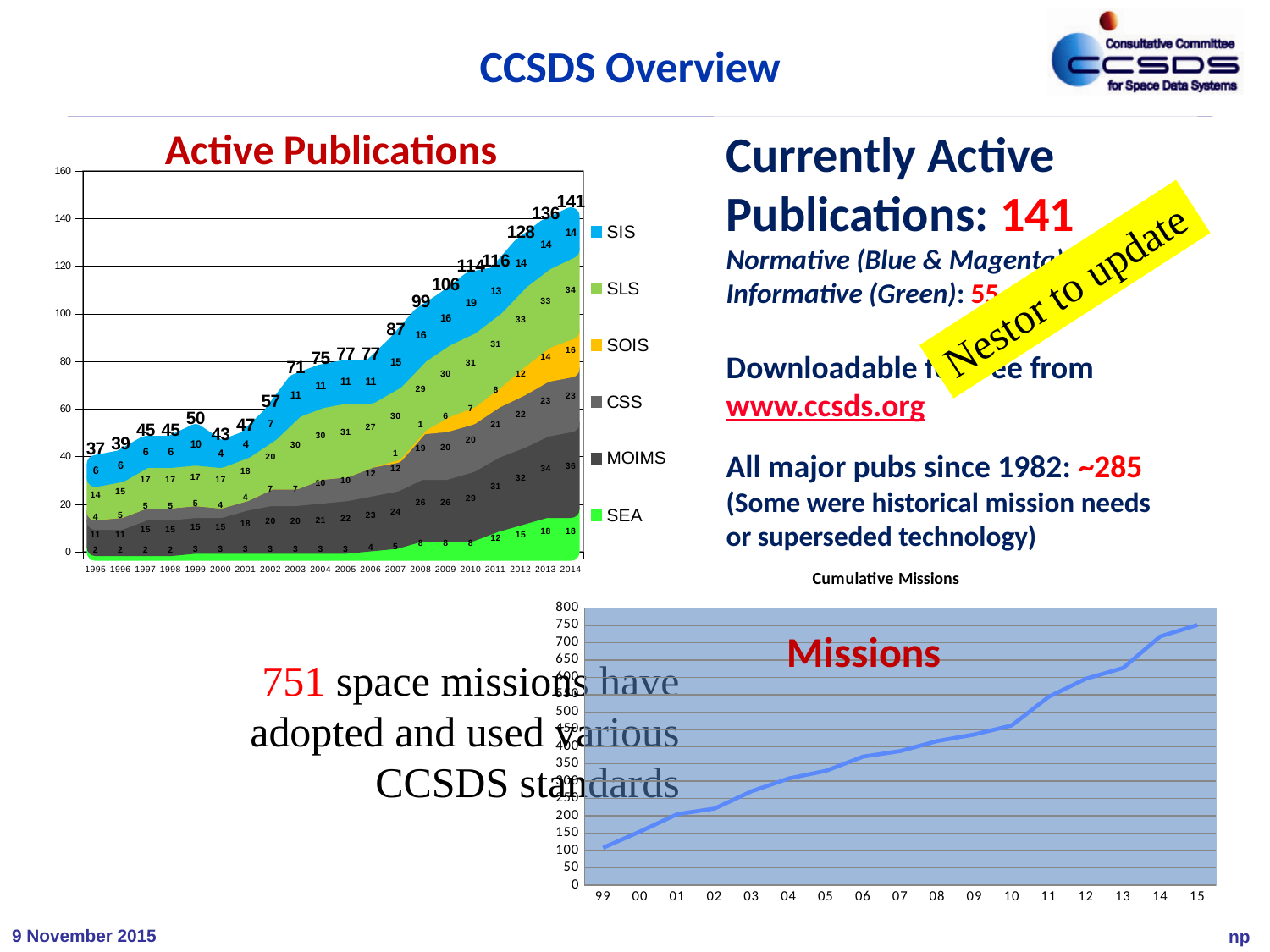
In the Active Publications chart, which year has the highest total of active publications? 2014 In the Cumulative Missions chart, is the value for 15 greater or less than 700? greater How many years are shown on the x axis of the Active Publications chart? 20 In the Active Publications chart, what is the total number of active publications shown for 2014? 141 In the Active Publications chart, which year has the lowest total of active publications? 1995 In the Active Publications chart, what is the difference between the totals for 2014 and 2013? 5 In the Cumulative Missions chart, do the values rise or fall from 99 to 15? rise What kind of chart is the Active Publications chart? Stacked area chart What kind of chart is the Cumulative Missions chart? Line chart How many series does the legend of the Active Publications chart list? 6 In the Active Publications chart, which year has the larger total, 1999 or 2000? 1999 In the Active Publications chart, what is the total number of active publications shown for 1995? 37